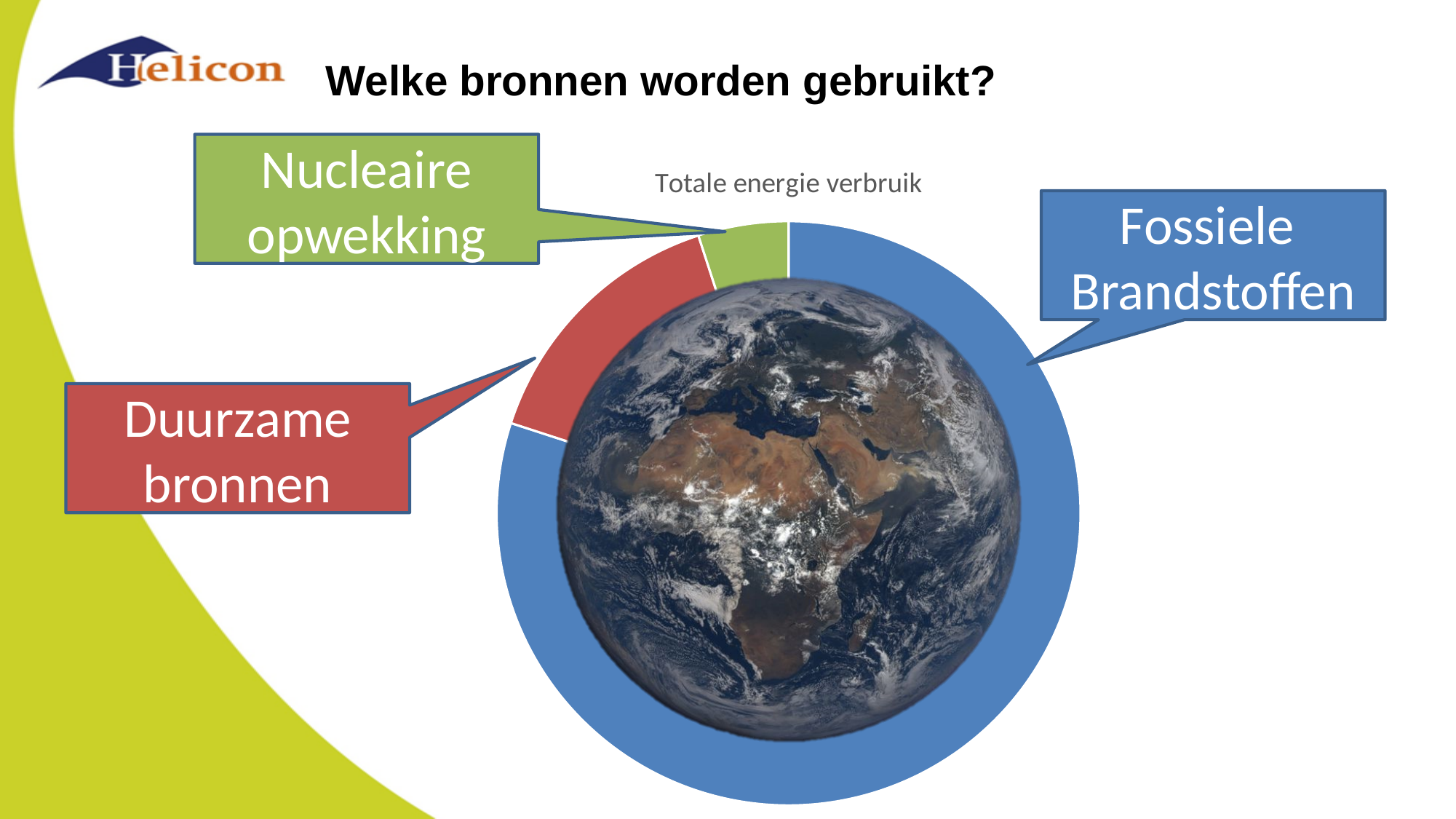
What is the title of the chart? Totale energie verbruik Which slice is larger, Fossiele Brandstoffen or Duurzame bronnen? Fossiele Brandstoffen Which energy source has the largest slice of the pie chart? Fossiele Brandstoffen Which energy source has the smallest slice of the pie chart? Nucleaire opwekking Does the Fossiele Brandstoffen slice take up more or less than half of the pie chart? more What kind of chart is shown on the slide? doughnut chart Which slice is larger, Duurzame bronnen or Nucleaire opwekking? Duurzame bronnen How many slices does the pie chart have? 3 What colour is the slice for Duurzame bronnen? red